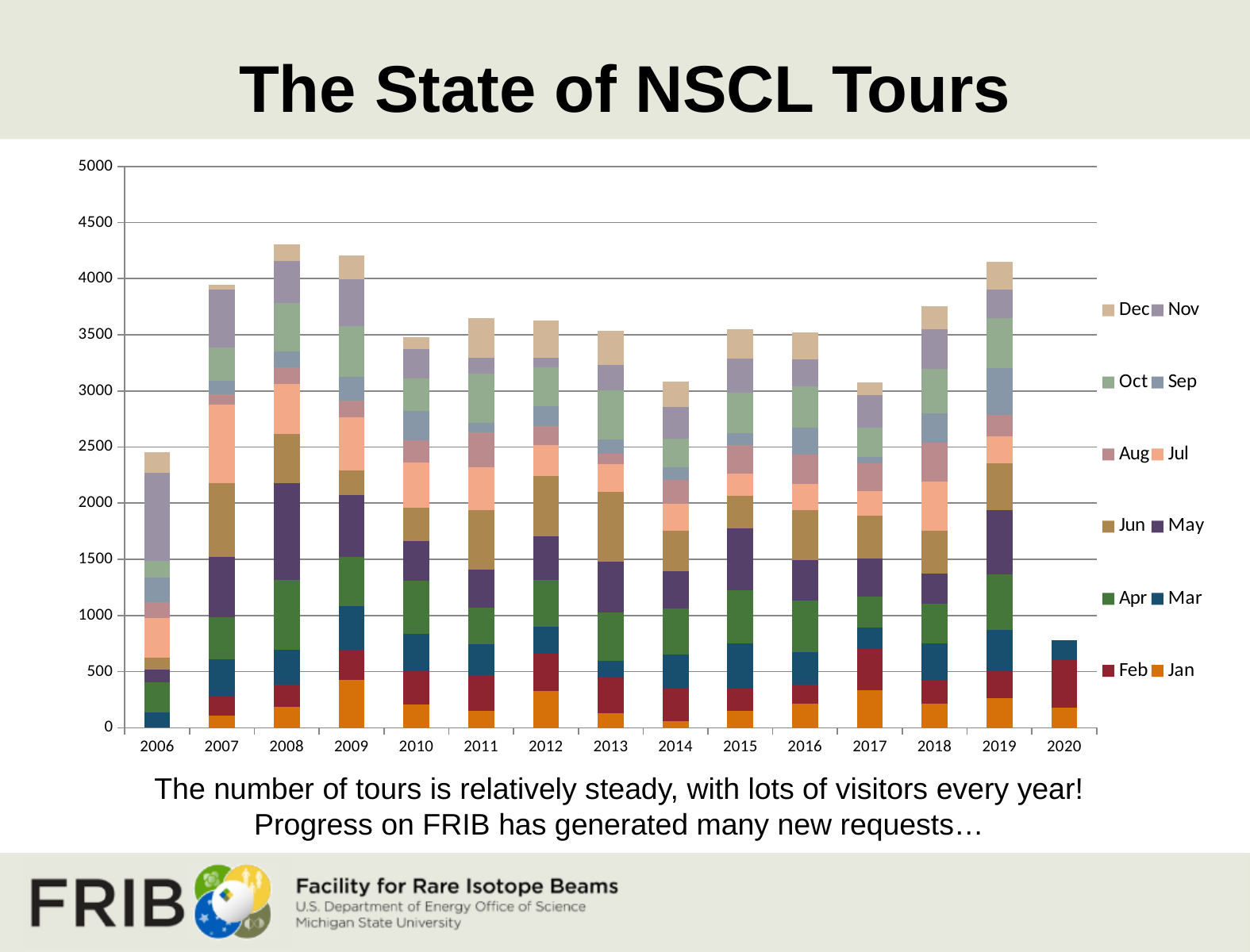
Is the total for 2020 greater or less than 1000? less How many series does the chart's legend list? 12 Which year has the lowest total bar in the chart? 2020 Is the total for 2008 greater or less than 4000? greater Which year has the larger total bar, 2006 or 2007? 2007 Is the total for 2019 greater or less than 4000? greater How many years are shown along the x axis of the chart? 15 What is the title of the slide containing the chart? The State of NSCL Tours Do the total bar heights rise or fall from 2006 to 2008? rise What kind of chart is shown on the slide? Stacked bar chart